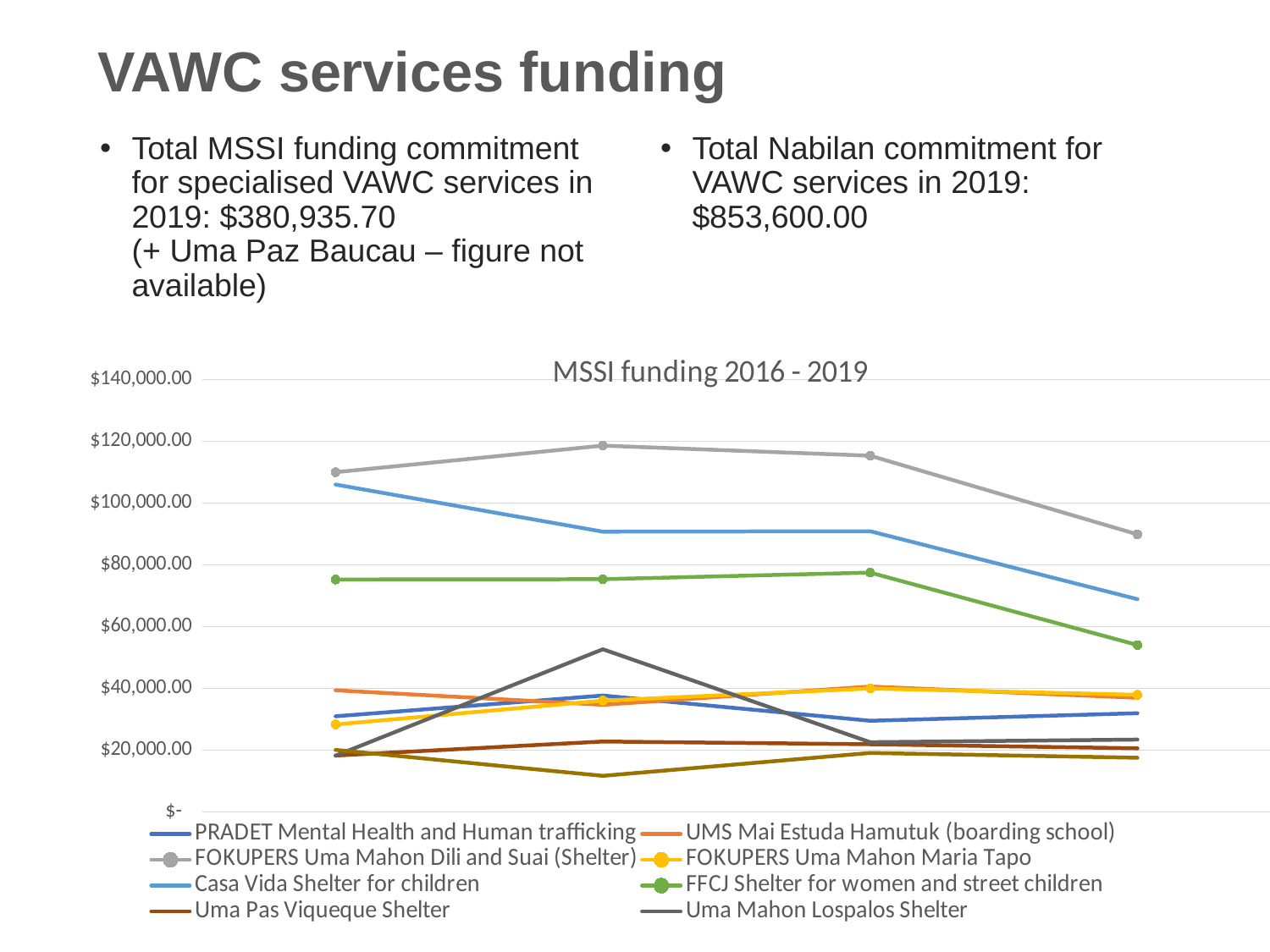
What kind of chart is shown on the slide? line chart Is the second value for Uma Mahon Lospalos Shelter greater or less than $40,000.00? greater Is the last value for Casa Vida Shelter for children greater or less than $80,000.00? less Is the last value for FFCJ Shelter for women and street children greater or less than $60,000.00? less How many data points does each line in the chart have? 4 What is the title of the chart? MSSI funding 2016 - 2019 At the first point, which is larger: Casa Vida Shelter for children or FFCJ Shelter for women and street children? Casa Vida Shelter for children Does the line for Casa Vida Shelter for children rise or fall from its first point to its last point? fall Which series has the highest values across the chart? FOKUPERS Uma Mahon Dili and Suai (Shelter) What is the highest value shown on the vertical axis of the chart? $140,000.00 How many series does the chart legend list? 8